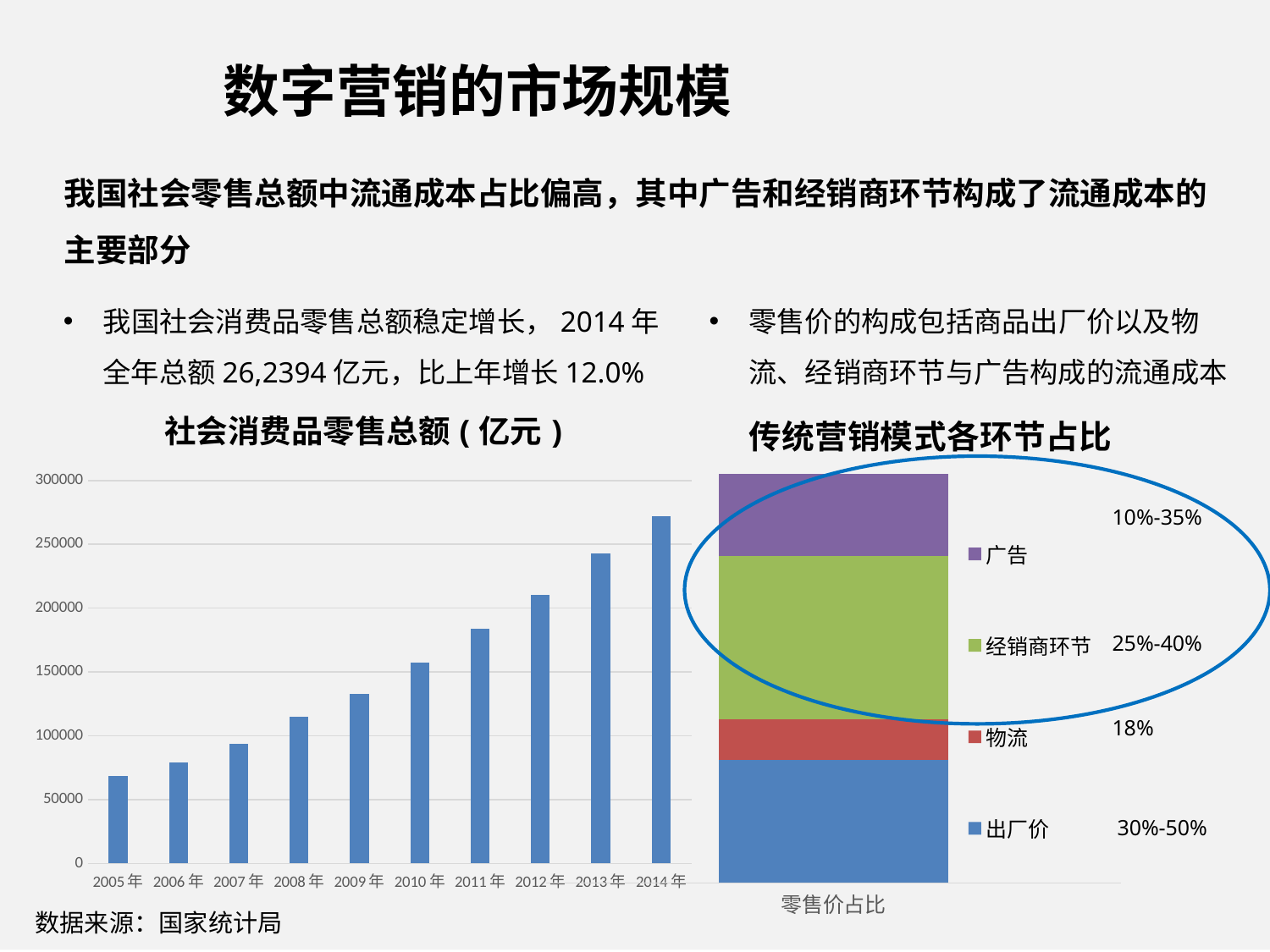
In the left chart 社会消费品零售总额（亿元）, which year has the lowest value? 2005年 In the left chart 社会消费品零售总额（亿元）, is the value for 2014年 greater or less than 250000? greater In the left chart 社会消费品零售总额（亿元）, do the values rise or fall from 2005年 to 2014年? rise In the left chart 社会消费品零售总额（亿元）, how many years are shown on the x axis? 10 In the left chart 社会消费品零售总额（亿元）, is the value for 2005年 greater or less than 100000? less In the right chart 传统营销模式各环节占比, how many series does the legend list? 4 In the right chart 传统营销模式各环节占比, what range is shown next to 经销商环节? 25%-40% What kind of chart is the left chart titled 社会消费品零售总额（亿元）? bar chart In the left chart 社会消费品零售总额（亿元）, is the value for 2011年 greater or less than 200000? less In the left chart 社会消费品零售总额（亿元）, which year has the highest value? 2014年 In the right chart 传统营销模式各环节占比, what percentage is shown next to 物流? 18% In the left chart 社会消费品零售总额（亿元）, which is larger, the value for 2009年 or the value for 2012年? 2012年